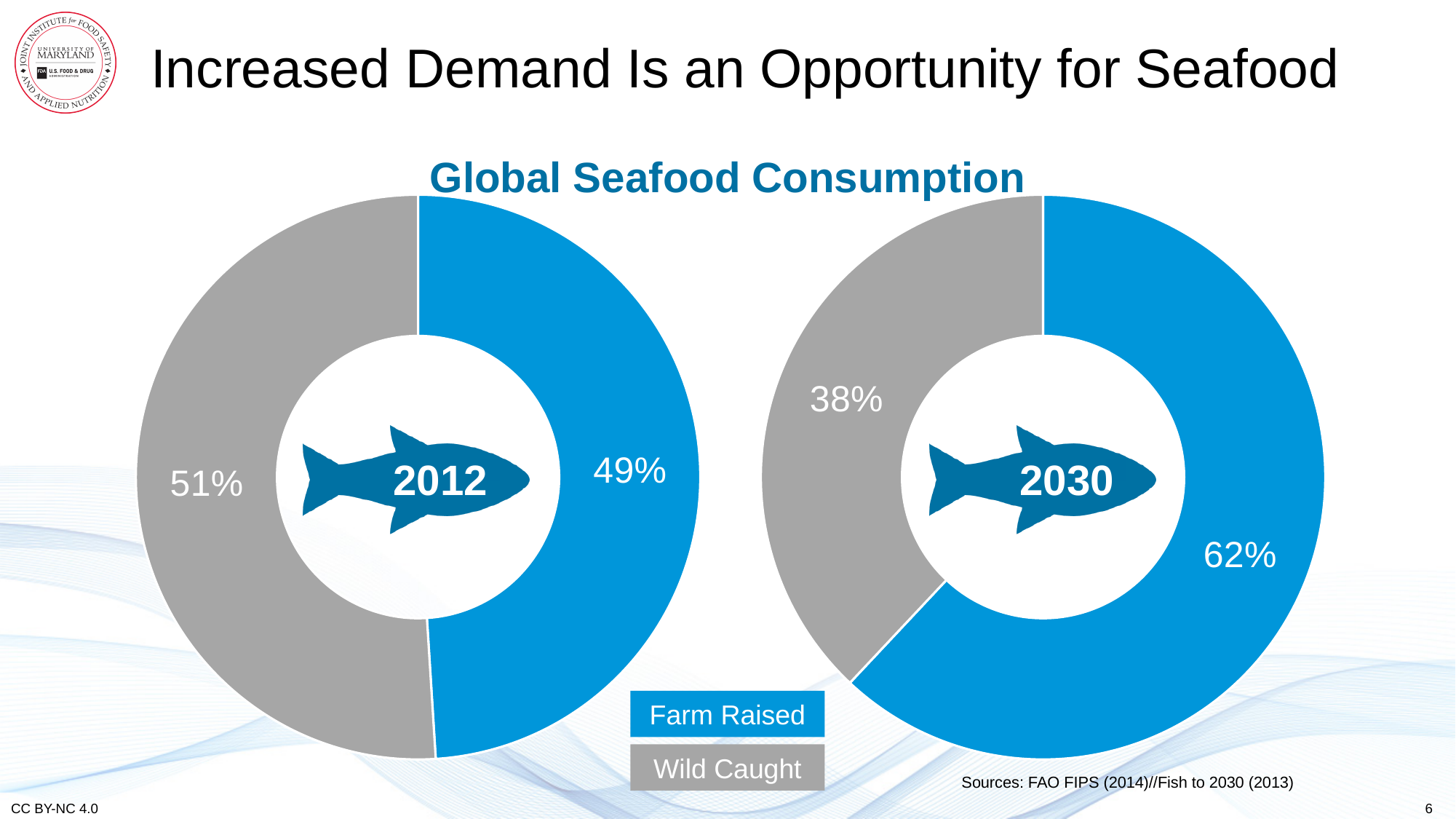
How many categories does the legend list for the Global Seafood Consumption charts? 2 In the 2012 chart, what share of global seafood consumption is Farm Raised? 49% In the 2030 chart, what share of global seafood consumption is Wild Caught? 38% What kind of chart is used to show Global Seafood Consumption for 2012 and 2030? Pie chart (donut) In the 2030 chart, what share of global seafood consumption is Farm Raised? 62% What colour represents Wild Caught in the Global Seafood Consumption charts? Gray In the 2030 chart, which category has the smallest share? Wild Caught In the 2012 chart, what share of global seafood consumption is Wild Caught? 51% By how many percentage points does the Farm Raised share increase from the 2012 chart to the 2030 chart? 13 In the 2030 chart, which category has the larger share, Farm Raised or Wild Caught? Farm Raised In the 2030 chart, what is the difference in percentage points between the Farm Raised and Wild Caught shares? 24 What is the title shown above the two pie charts? Global Seafood Consumption